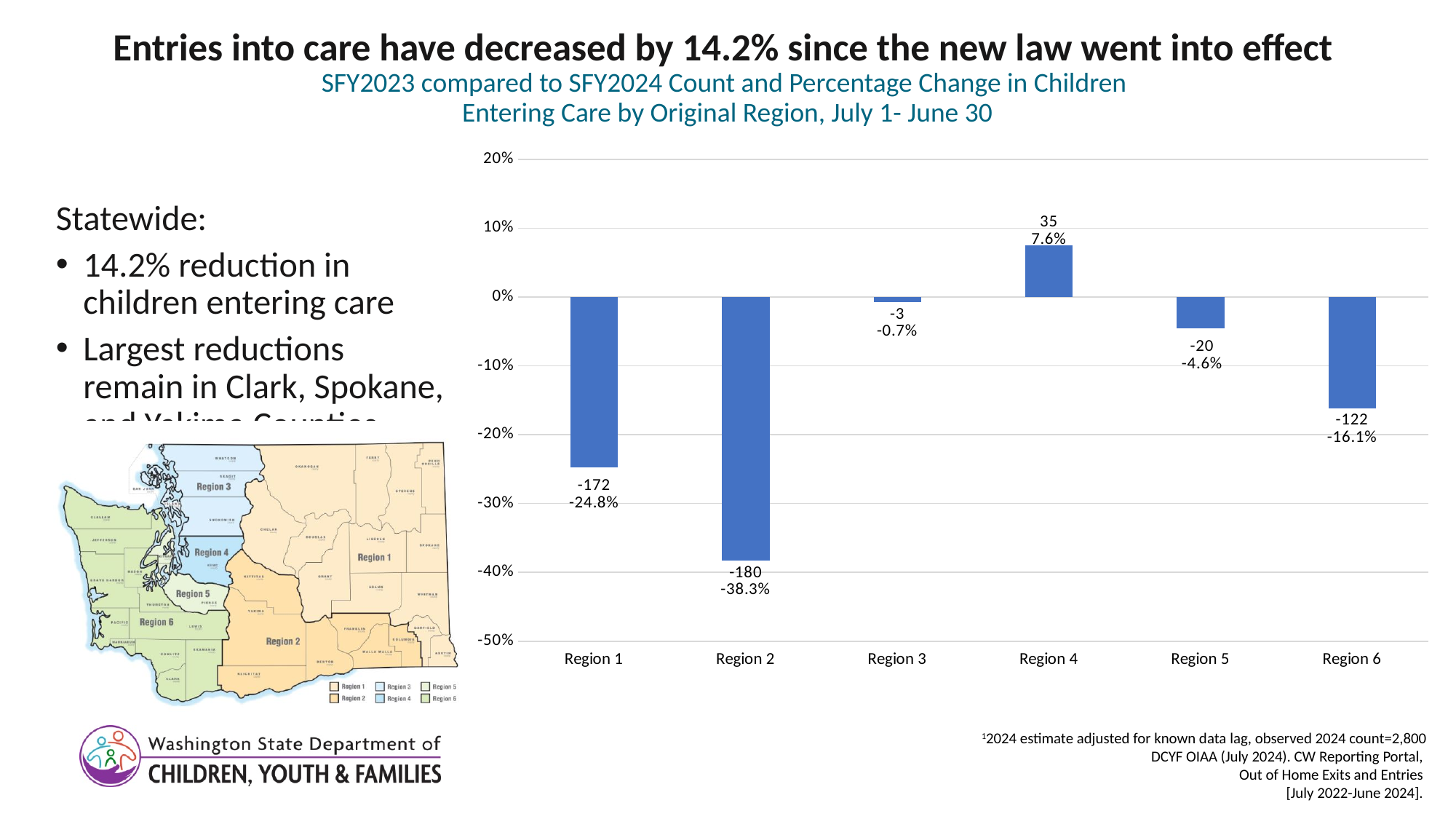
How many regions are shown on the x axis of the chart? 6 What is the percentage change shown for Region 3? -0.7% What is the percentage change shown for Region 4? 7.6% Which region is the only one with a positive percentage change? Region 4 What is the difference in count change between Region 2 and Region 1? 8 Which region shows the largest percentage decrease in children entering care? Region 2 Which region has a larger percentage decrease, Region 5 or Region 6? Region 6 What is the count change shown for Region 6? -122 Is the percentage change for Region 1 greater or less than -20%? less What is the percentage change in children entering care for Region 2? -38.3% What is the count change in children entering care for Region 1? -172 What kind of chart is used to show the change in children entering care by region? bar chart